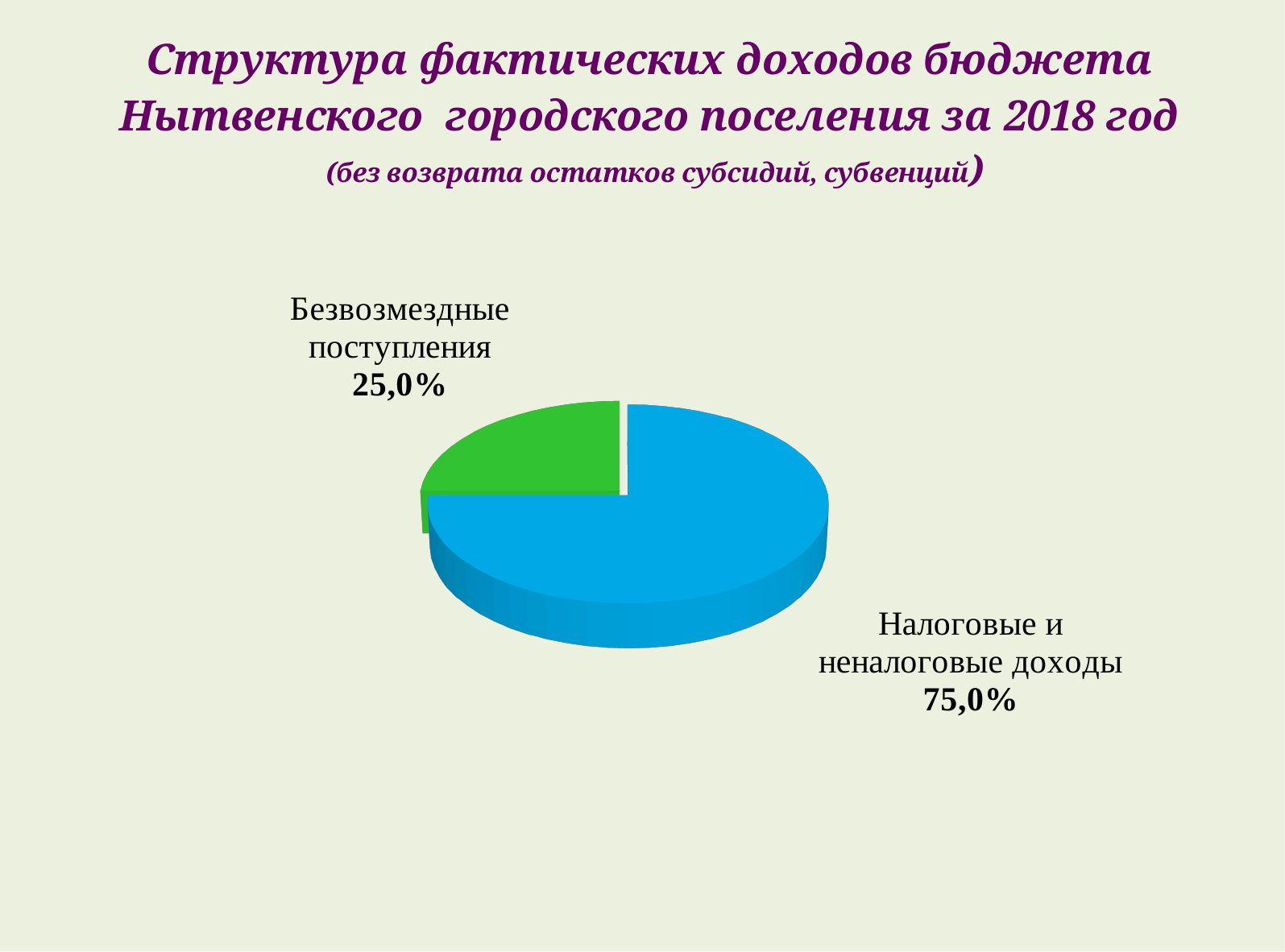
Which category has the largest share of the pie? Налоговые и неналоговые доходы What colour is the slice for "Налоговые и неналоговые доходы"? Blue What type of chart is shown on the slide? Pie chart What is the difference in percentage points between "Налоговые и неналоговые доходы" and "Безвозмездные поступления"? 50,0% Which is larger: the share for "Безвозмездные поступления" or the share for "Налоговые и неналоговые доходы"? Налоговые и неналоговые доходы How many slices does the pie chart have? 2 Which category has the smallest share of the pie? Безвозмездные поступления What share of the pie is labelled "Безвозмездные поступления"? 25,0% What colour is the slice for "Безвозмездные поступления"? Green What share of the pie is labelled "Налоговые и неналоговые доходы"? 75,0% What is the total of the two slices shown in the pie chart? 100,0%